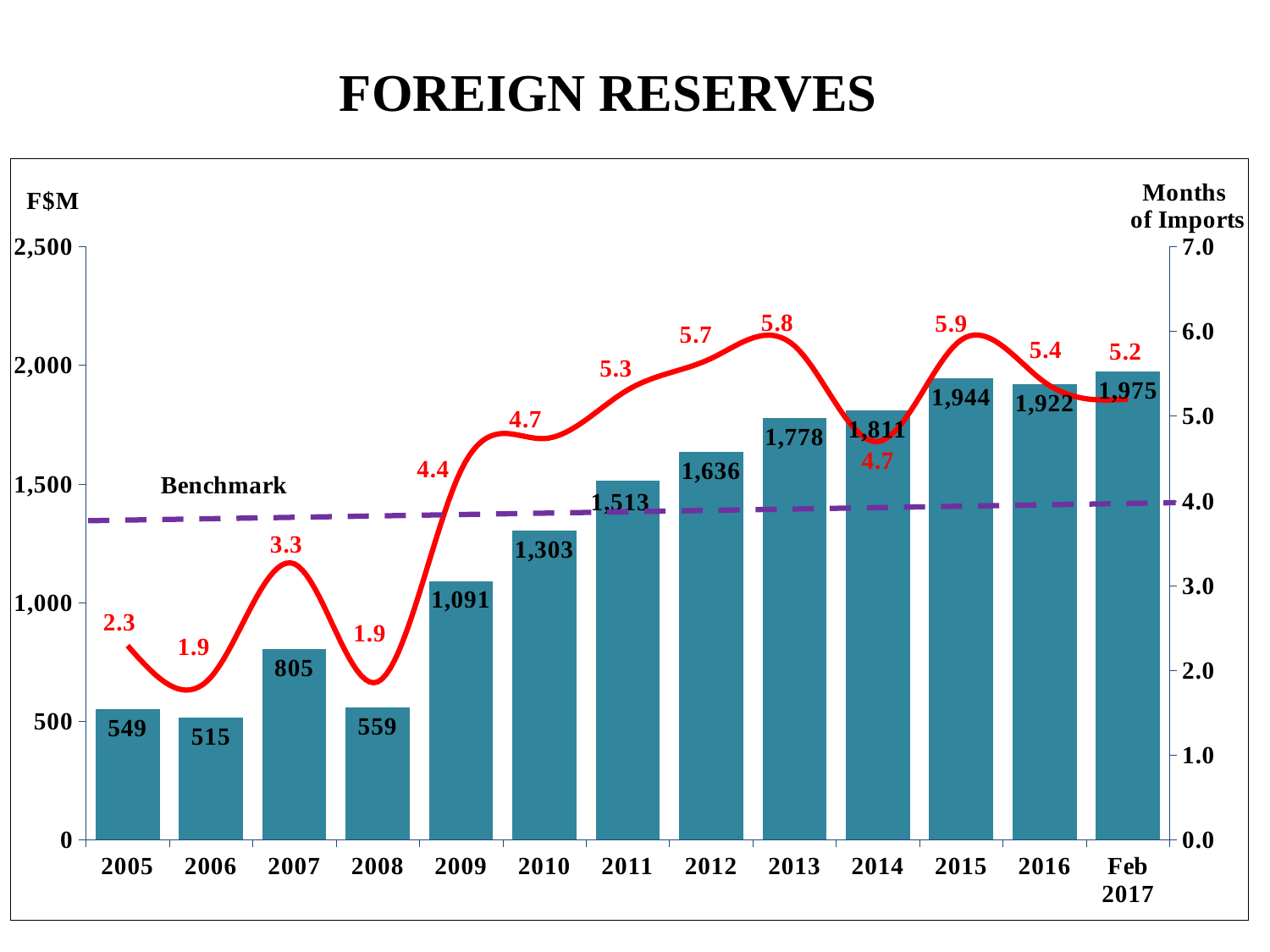
What is the foreign reserves value (F$M) for 2010? 1,303 Do the foreign reserves bars generally rise or fall from 2008 to Feb 2017? rise What is the difference in foreign reserves (F$M) between 2015 and 2014? 133 Which year has higher foreign reserves, 2015 or 2016? 2015 How many time periods are shown on the x axis? 13 Which year has the lowest foreign reserves bar? 2006 Which period has the highest foreign reserves bar? Feb 2017 In which year does the months of imports line reach its highest value? 2015 Is the Benchmark line value in 2005 greater or less than 3.0 months of imports? greater What is the months of imports value shown for 2013? 5.8 What kind of chart is used for the foreign reserves values in F$M? bar chart What is the foreign reserves value (F$M) for Feb 2017? 1,975